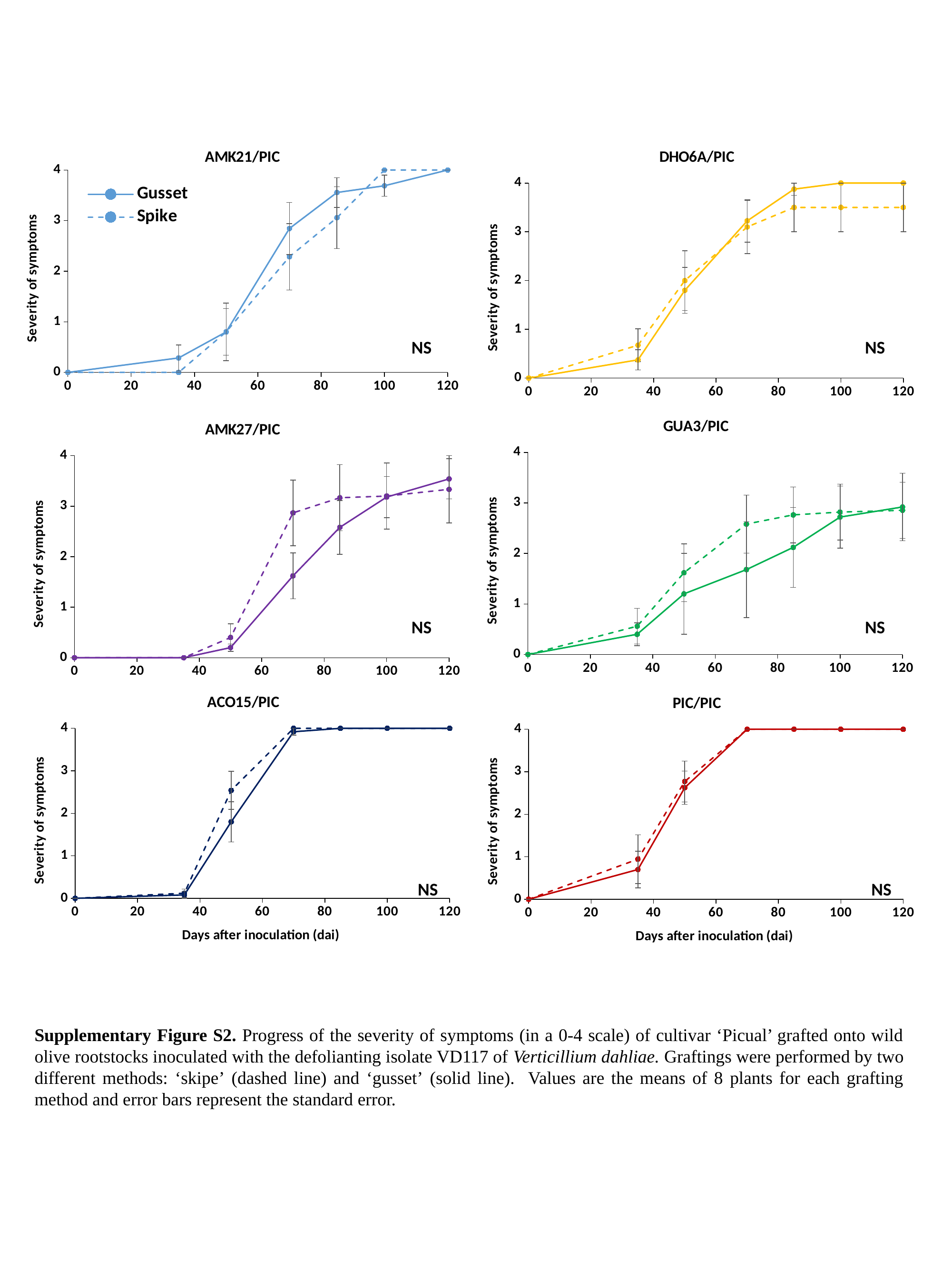
What kind of chart is AMK21/PIC? Line chart In the AMK27/PIC chart, what is the severity of symptoms for Gusset at 35 days after inoculation? 0 In the GUA3/PIC chart, is the Spike value at 70 days after inoculation greater or less than 2? greater What label is printed on the x axis of the ACO15/PIC chart? Days after inoculation (dai) In the ACO15/PIC chart, which series has the higher severity at 50 days after inoculation, Gusset or Spike? Spike In the AMK27/PIC chart, is the Gusset value at 70 days after inoculation greater or less than 2? less How many charts are shown on the slide? 6 How many series does the legend on the AMK21/PIC chart list? 2 In the PIC/PIC chart, what is the severity of symptoms for Gusset at 120 days after inoculation? 4 In the DHO6A/PIC chart, do the severity values rise or fall as days after inoculation increase? Rise In the ACO15/PIC chart, what is the severity of symptoms for Spike at 100 days after inoculation? 4 What are the two series named in the legend of the AMK21/PIC chart? Gusset and Spike